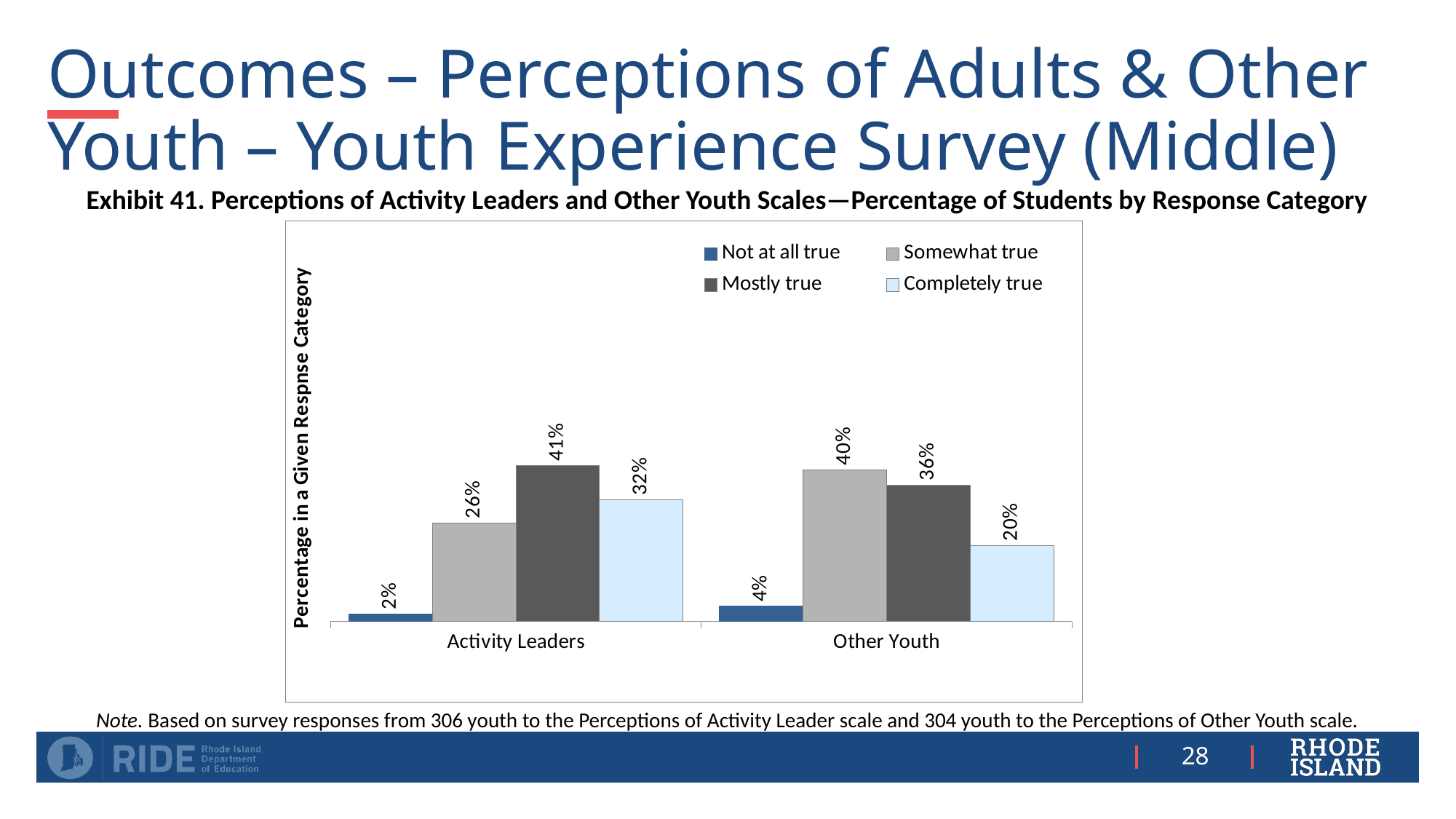
What kind of chart is shown on the slide? Bar chart What is the label of the y axis? Percentage in a Given Respnse Category What percentage of students responded "Not at all true" for Activity Leaders? 2% Which response category has the lowest percentage for Activity Leaders? Not at all true Which response category has the highest percentage for Other Youth? Somewhat true What percentage of students responded "Completely true" for Other Youth? 20% How many categories are shown on the x axis? 2 What is the difference between the "Completely true" percentages for Activity Leaders and Other Youth? 12% How many series does the legend list? 4 Which is larger: the "Somewhat true" percentage for Activity Leaders or for Other Youth? Other Youth What percentage of students responded "Mostly true" for Activity Leaders? 41% What percentage of students responded "Somewhat true" for Other Youth? 40%